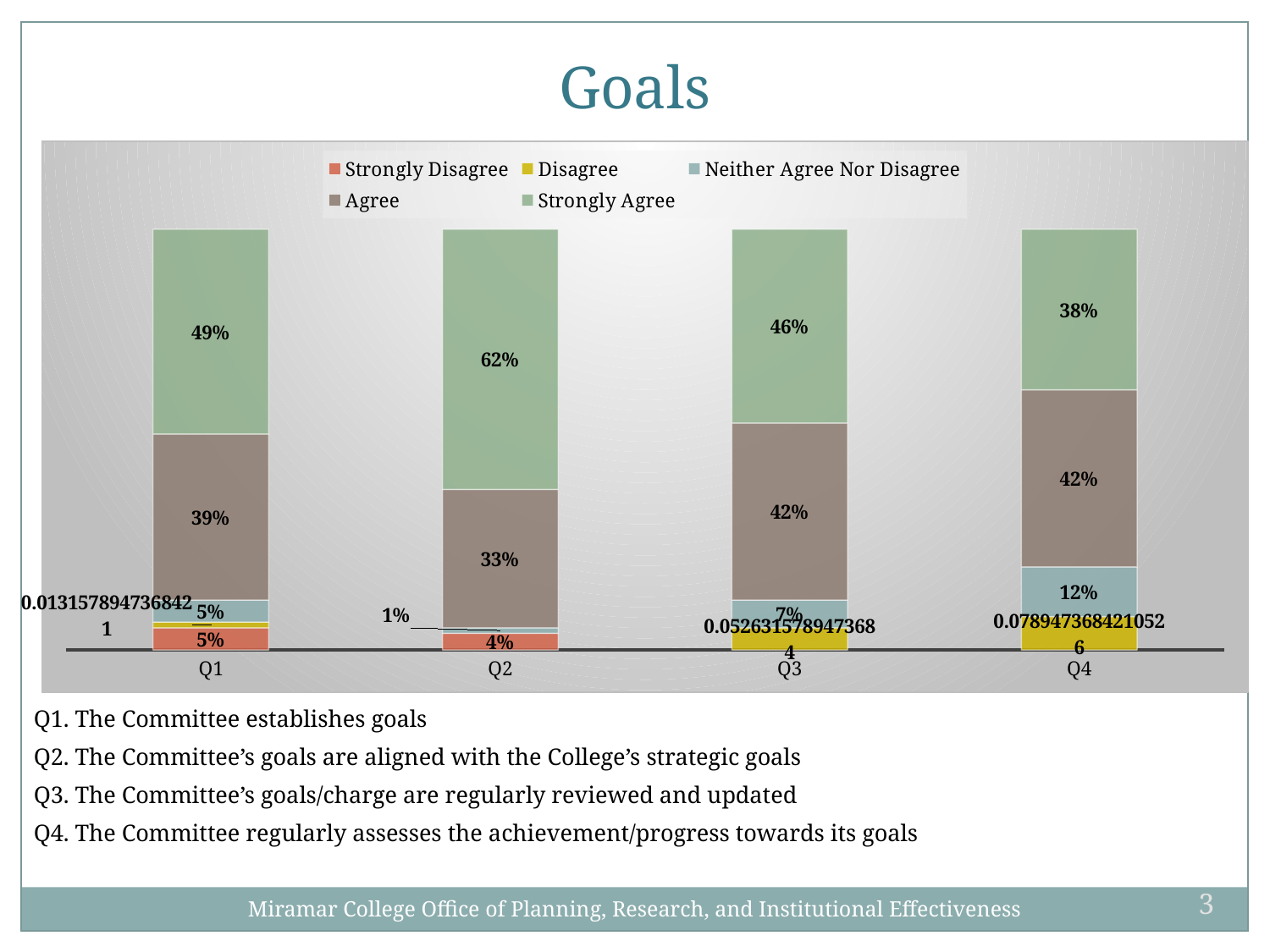
For Q3, which is larger: the Agree value or the Strongly Agree value? Strongly Agree What is the Neither Agree Nor Disagree value for Q4? 12% How many series does the legend list? 5 What is the Agree value for Q1? 39% What is the difference between the Strongly Agree values for Q2 and Q1? 13 percentage points What kind of chart is shown on the slide? Stacked bar chart Which question has the highest Strongly Agree value? Q2 Which question has the lowest Strongly Agree value? Q4 What is the title of the chart? Goals What is the Strongly Agree value for Q2? 62% What is the Strongly Disagree value for Q1? 5% How many question categories are plotted along the x axis? 4